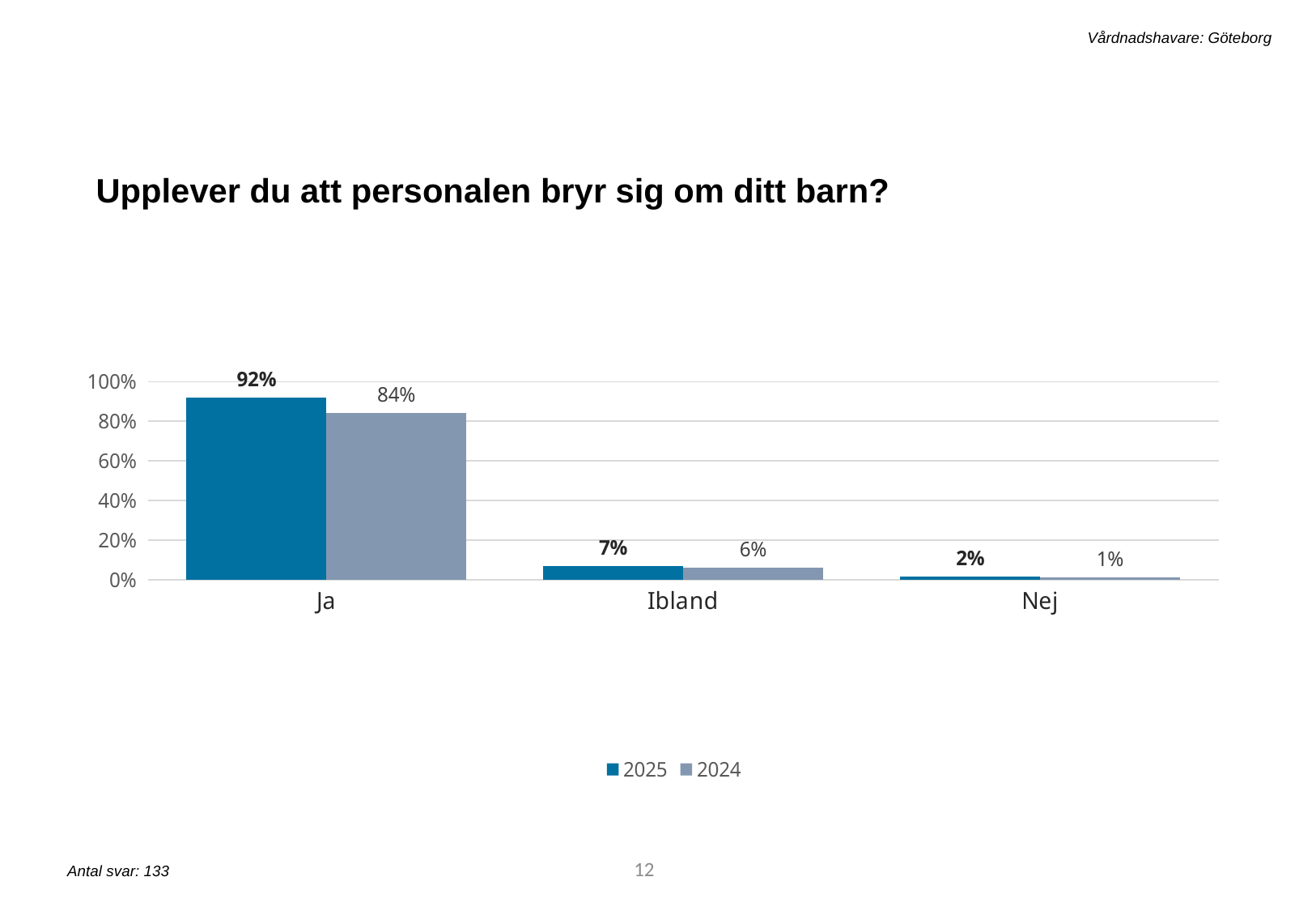
What is the value for "Ja" in the 2024 series? 84% What kind of chart is shown on the slide? Bar chart What is the difference between the 2025 and 2024 values for "Ja"? 8% Which is larger for "Ibland": the 2025 value or the 2024 value? 2025 Which category has the highest value in the 2025 series? Ja Is the 2024 value for "Ja" greater or less than 80%? greater How many categories are shown on the x axis? 3 What is the value for "Nej" in the 2024 series? 1% What is the value for "Ja" in the 2025 series? 92% Which category has the lowest value in the 2024 series? Nej What is the value for "Ibland" in the 2025 series? 7% How many series does the legend list? 2